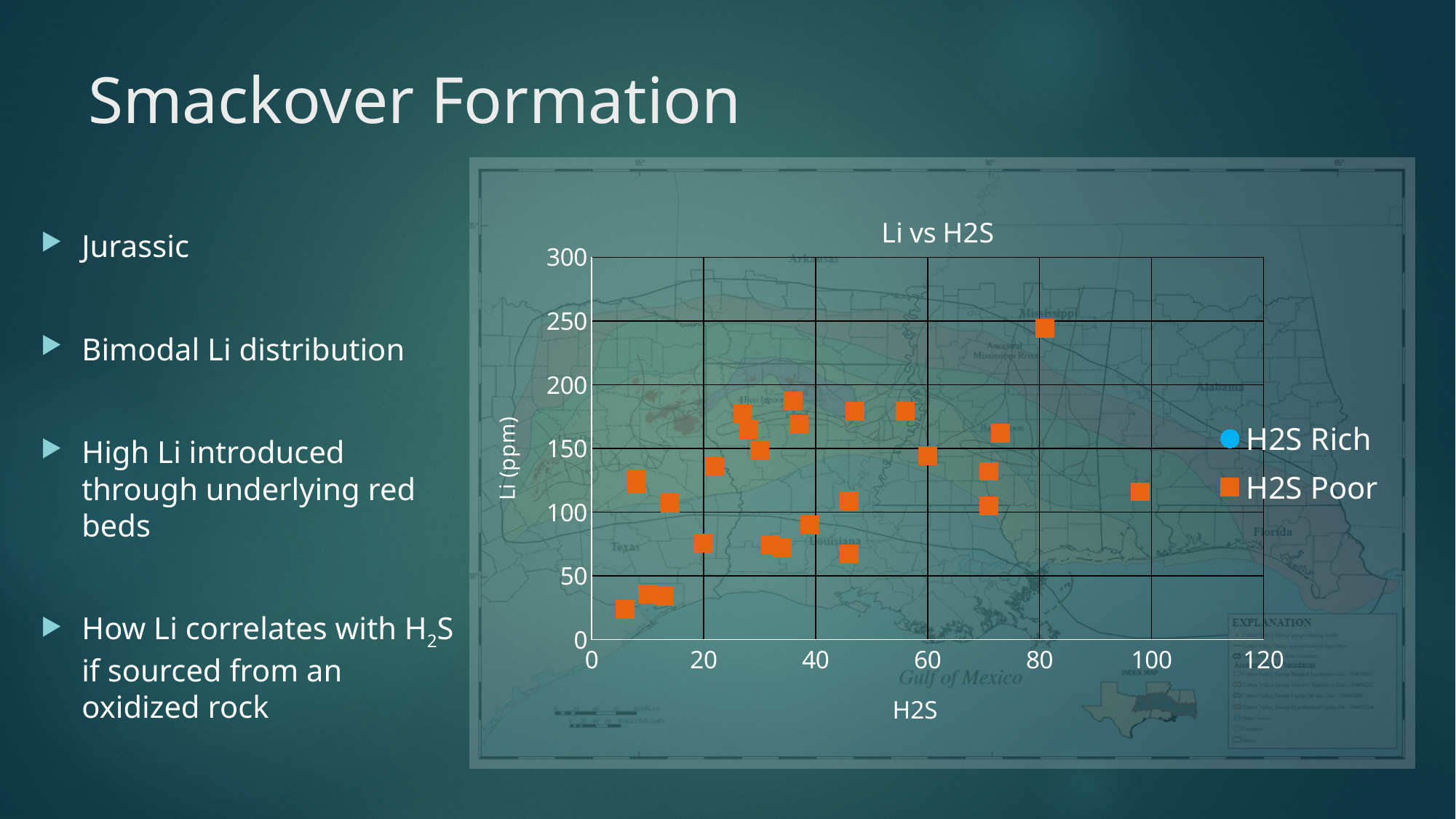
What is the maximum value shown on the Li (ppm) axis? 300 Is the lowest Li (ppm) value plotted greater or less than 50? less Is the Li (ppm) value of the point plotted at about H2S 100 greater or less than 150? less How many series does the chart legend list? 2 Is the highest Li (ppm) value plotted greater or less than 200? greater What is the title of the chart? Li vs H2S What kind of chart is shown on the slide? scatter chart What is the maximum value shown on the H2S axis? 120 Which has the larger Li (ppm) value: the point plotted at about H2S 80 or the point at about H2S 100? the point at about H2S 80 Which series is shown with orange square markers? H2S Poor